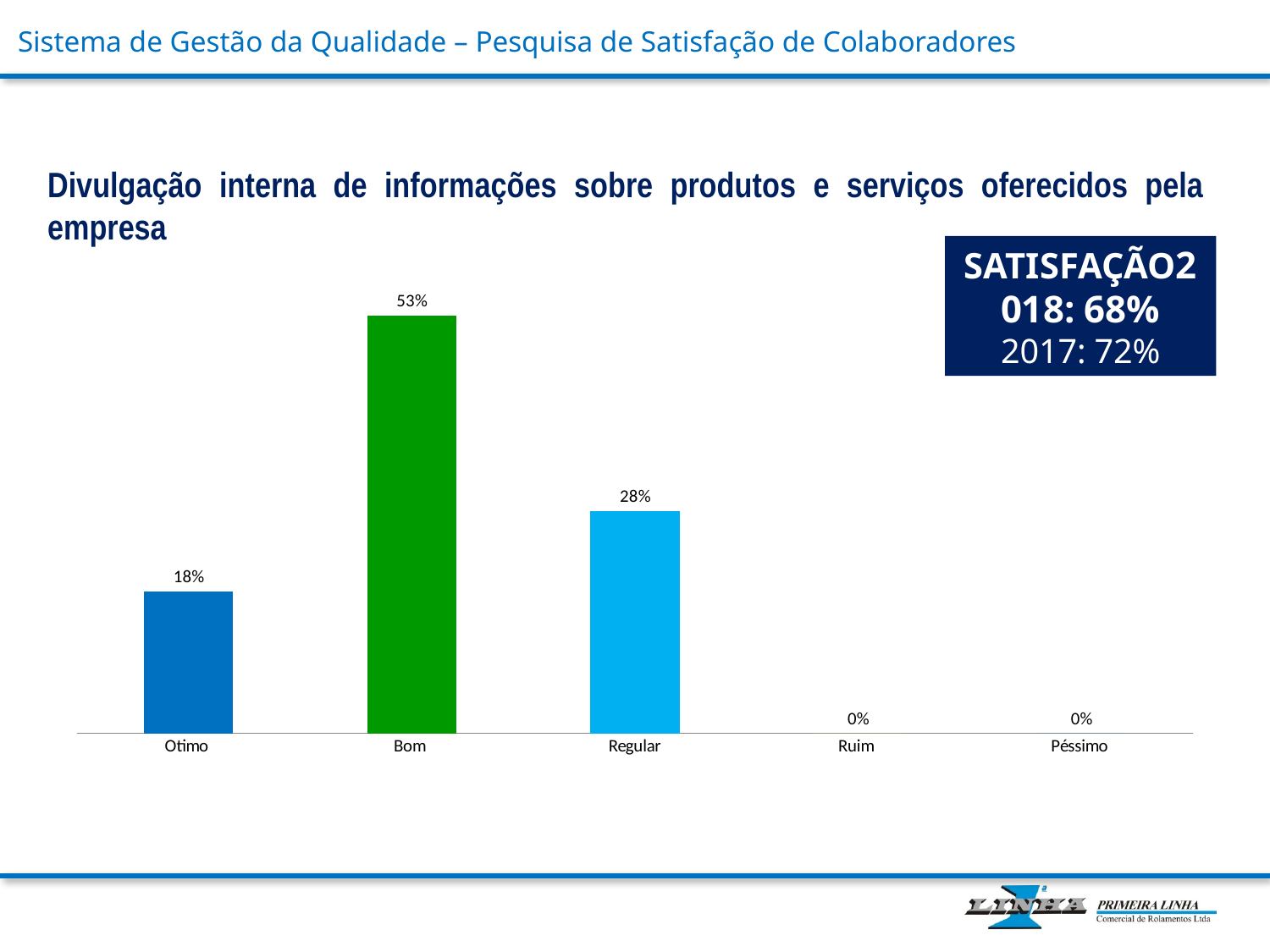
What is the difference between the values for Regular and Otimo? 10% What colour is the bar for Bom? Green What is the value for Bom? 53% What is the value for Otimo? 18% What kind of chart is shown on the slide? Bar chart How many categories are shown on the x axis? 5 Which category has the highest value? Bom What is the difference between the values for Bom and Regular? 25% What is the value for Ruim? 0% Which is larger, the value for Otimo or the value for Regular? Regular How many categories have a value of 0%? 2 What is the value for Regular? 28%